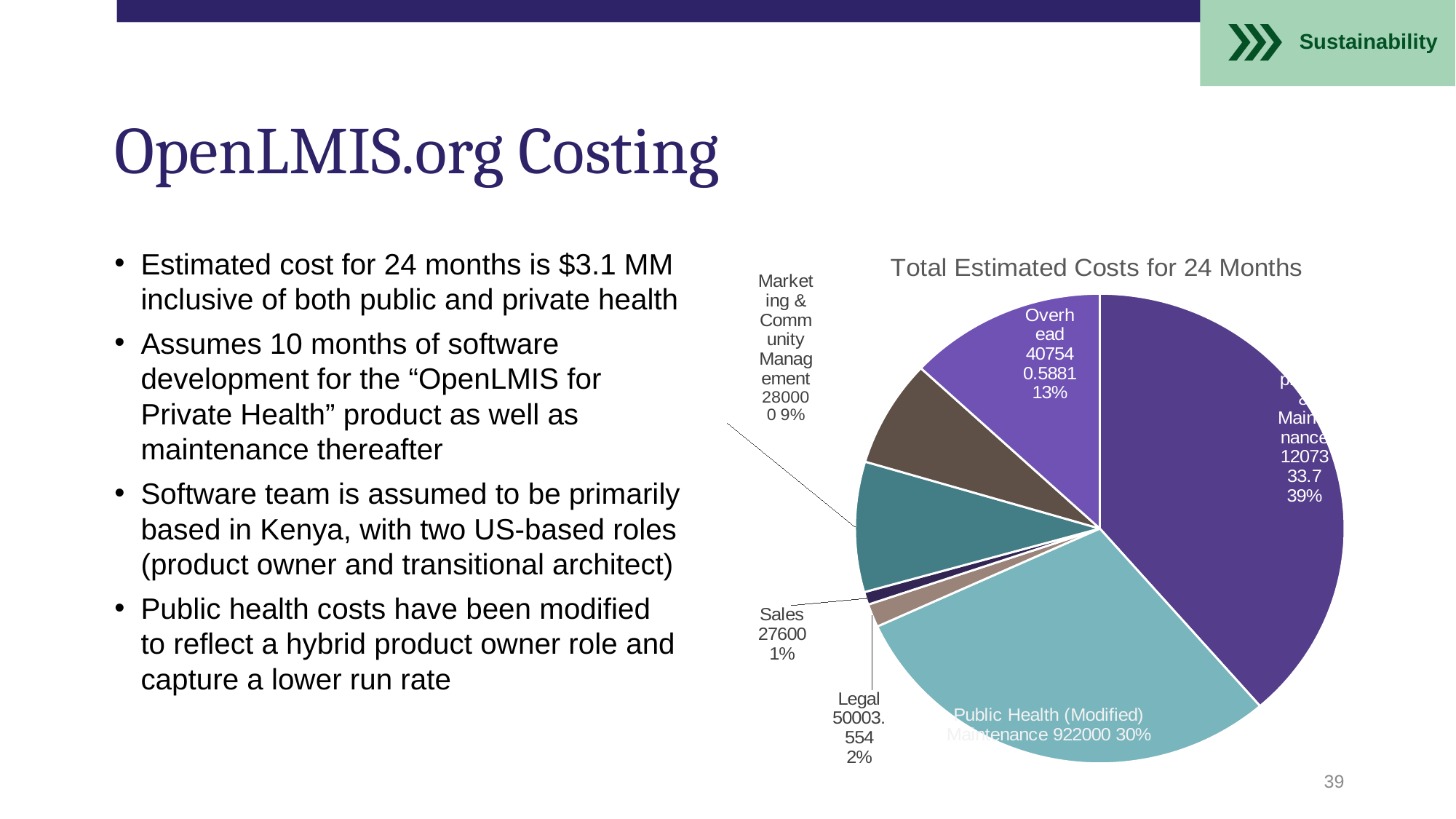
What share of the pie does Marketing & Community Management represent? 9% What share of the pie does Public Health (Modified) Maintenance represent? 30% What is the value shown for Public Health (Modified) Maintenance? 922000 What share of the pie does Sales represent? 1% Which is larger, the Public Health (Modified) Maintenance slice or the Overhead slice? Public Health (Modified) Maintenance What is the value shown for Marketing & Community Management? 280000 What is the difference in percentage share between Public Health (Modified) Maintenance and Overhead? 17% What is the title of the chart? Total Estimated Costs for 24 Months What is the value shown for Sales? 27600 What kind of chart is shown on the slide? pie chart